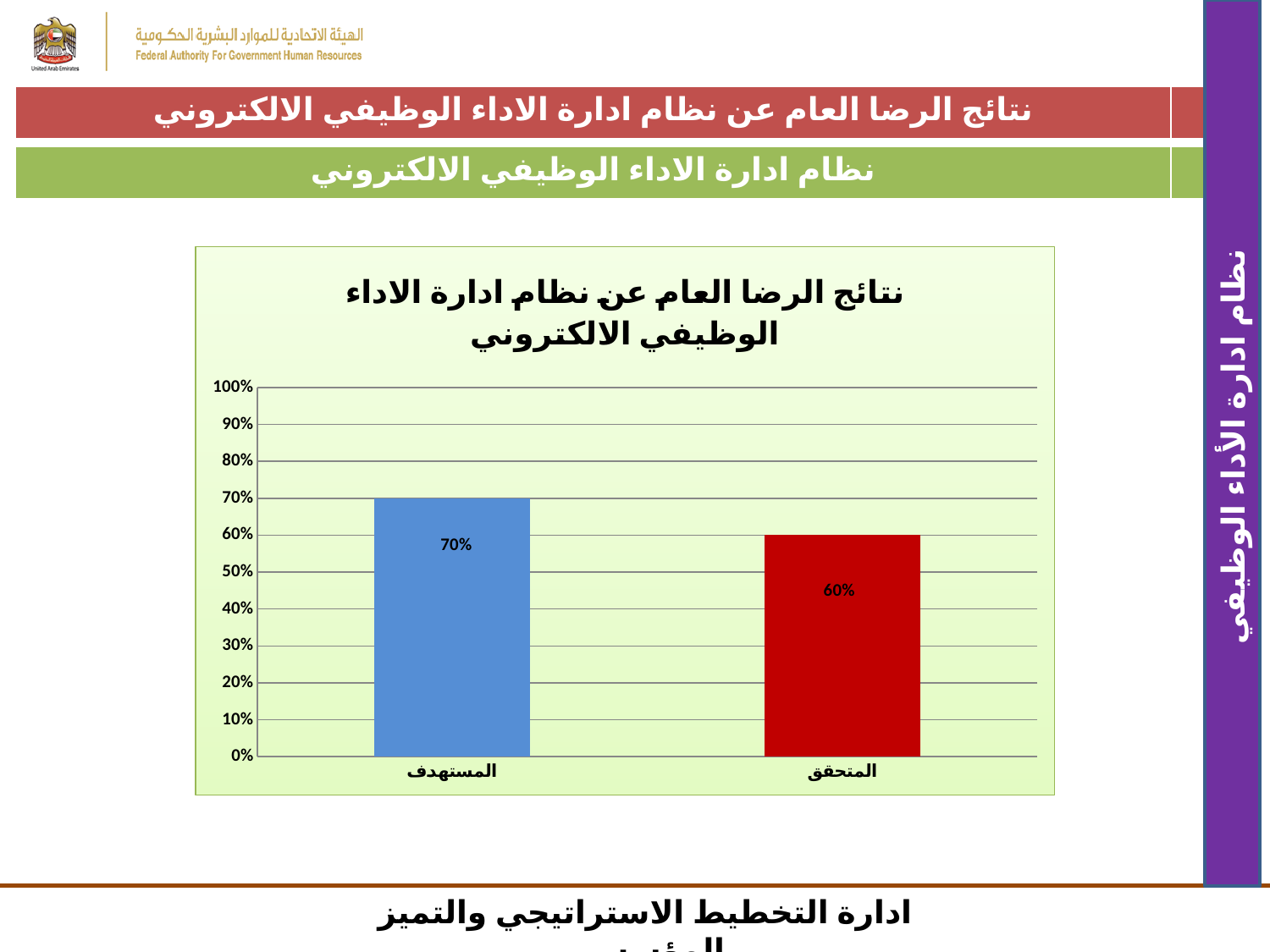
What kind of chart is shown on the slide? bar chart What is the value for المستهدف? 70% What colour is the bar for المتحقق? red What is the value for المتحقق? 60% Is the value for المتحقق greater or less than 80%? less Is the value for المستهدف greater or less than 50%? greater What is the difference between the values for المستهدف and المتحقق? 10% Which category has the lowest value? المتحقق Which category has the highest value? المستهدف How many categories are shown on the x axis? 2 Which is larger, the value for المستهدف or the value for المتحقق? المستهدف What is the title of the chart? نتائج الرضا العام عن نظام ادارة الاداء الوظيفي الالكتروني